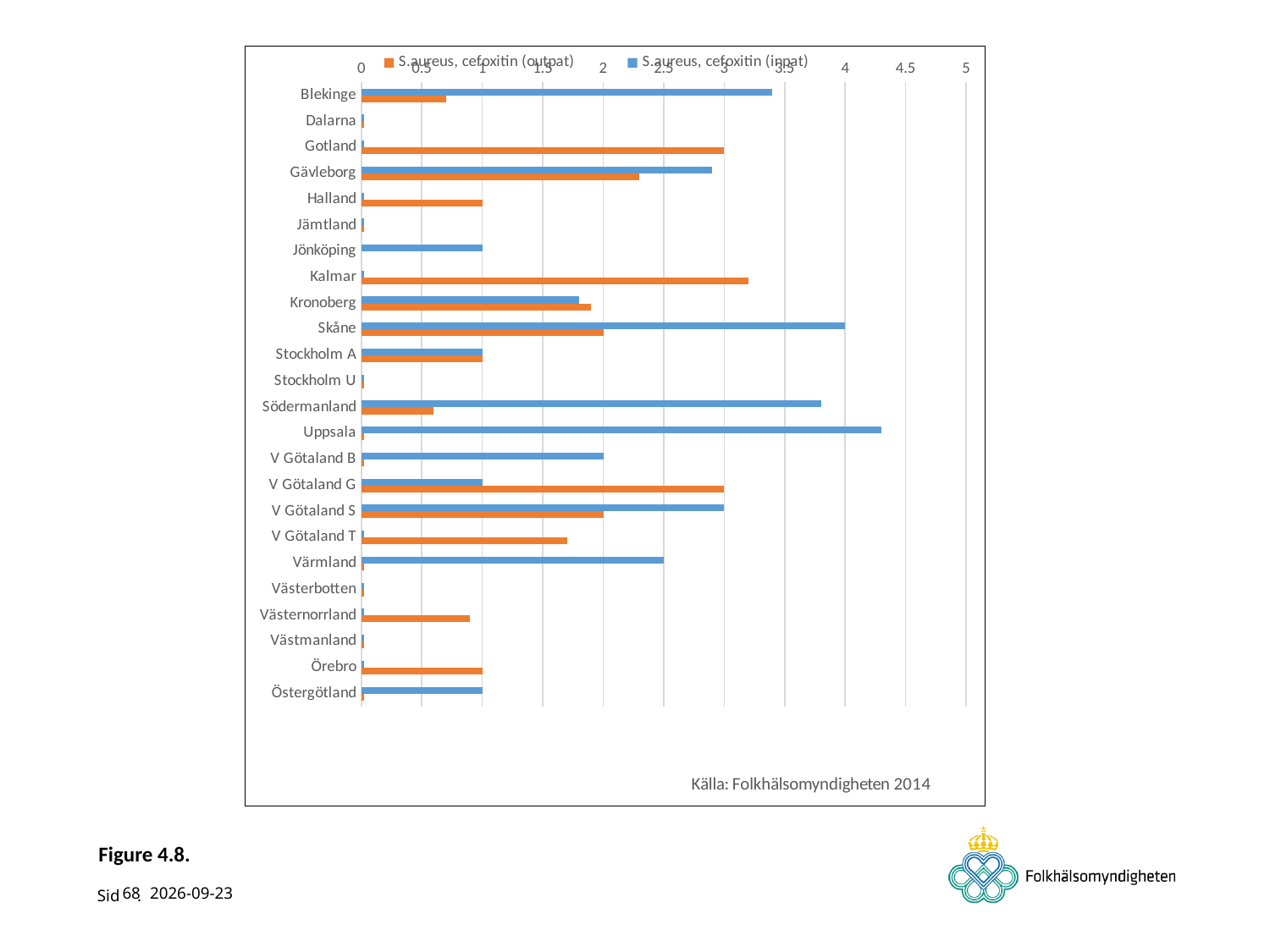
Which region has the highest value for S.aureus, cefoxitin (inpat)? Uppsala What kind of chart is shown on the slide? Bar chart What is the value of S.aureus, cefoxitin (inpat) for Värmland? 2.5 What is the value of S.aureus, cefoxitin (outpat) for V Götaland G? 3 What source is cited at the bottom of the chart? Källa: Folkhälsomyndigheten 2014 How many regions (categories) are plotted on the chart? 24 Is the value of S.aureus, cefoxitin (inpat) for Uppsala greater or less than 4? greater How many series does the legend list? 2 What is the difference between the inpat and outpat values for V Götaland S? 1 What is the value of S.aureus, cefoxitin (inpat) for Skåne? 4 For Skåne, which is larger: S.aureus, cefoxitin (inpat) or S.aureus, cefoxitin (outpat)? S.aureus, cefoxitin (inpat) Is the value of S.aureus, cefoxitin (outpat) for Gävleborg greater or less than 2? greater